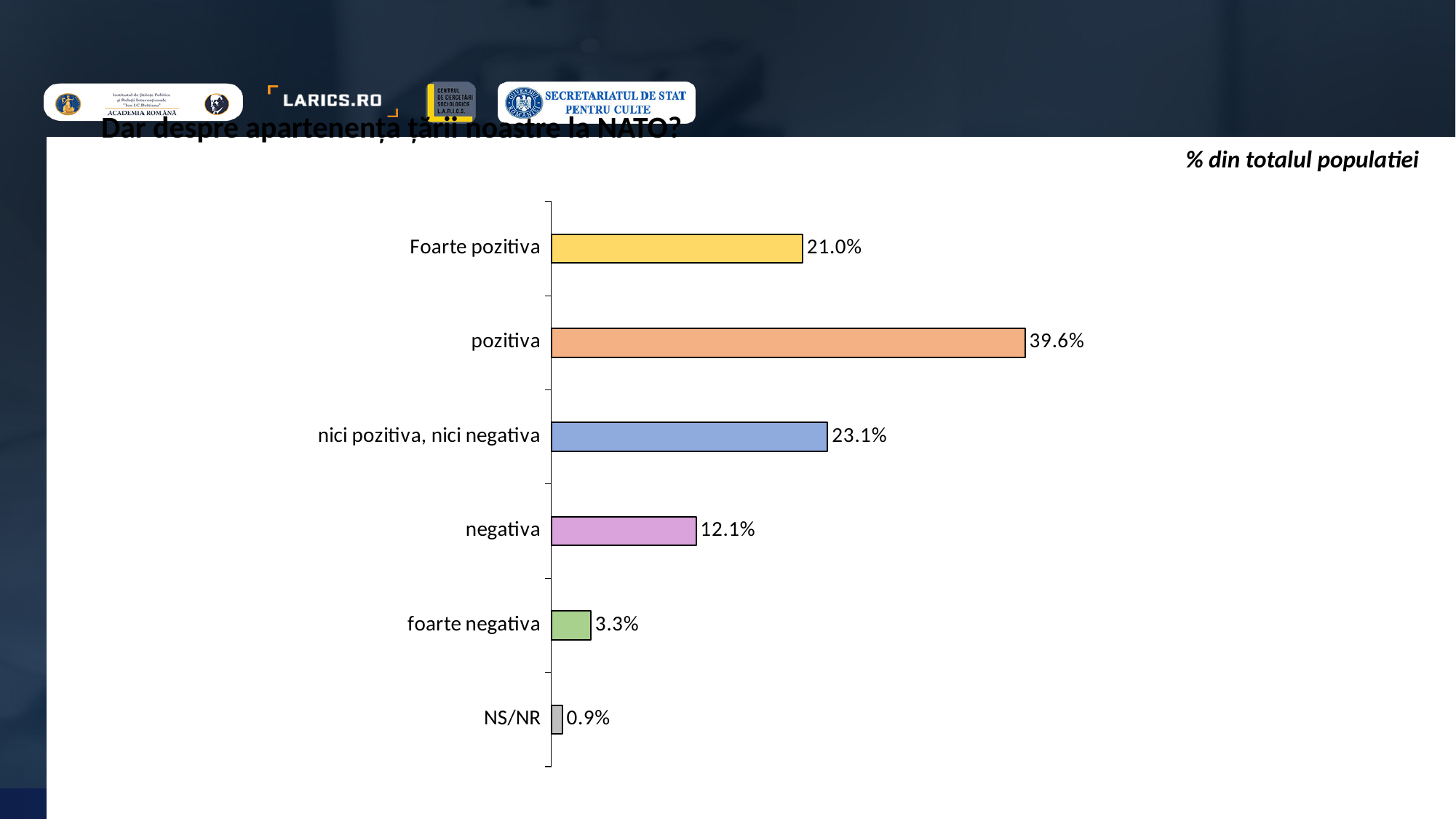
Which category has the lowest value? NS/NR Which category has the highest value? pozitiva What is the value for "negativa"? 12.1% What is the value for "NS/NR"? 0.9% What is the value for "Foarte pozitiva"? 21.0% What is the value for "pozitiva"? 39.6% What is the difference between the values for "pozitiva" and "Foarte pozitiva"? 18.6% What is the difference between the values for "negativa" and "foarte negativa"? 8.8% How many categories are shown in the chart? 6 Which is larger, the value for "nici pozitiva, nici negativa" or the value for "negativa"? nici pozitiva, nici negativa What is the value for "nici pozitiva, nici negativa"? 23.1% What kind of chart is shown on the slide? bar chart